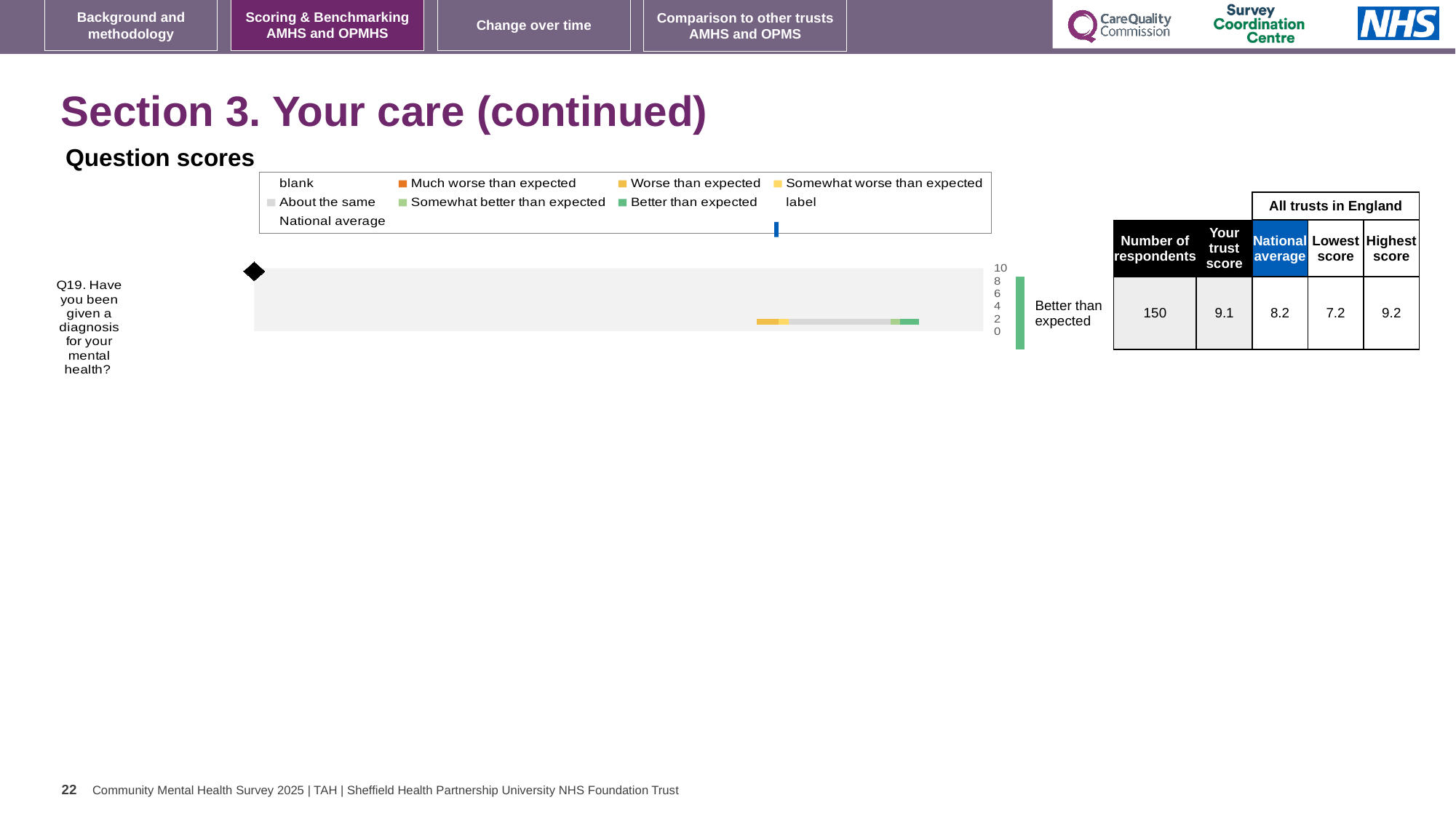
What kind of chart is shown under 'Question scores'? bar chart How many survey questions are plotted in the Question scores chart? 1 What is the highest score among all trusts in England for Q19? 9.2 What is the lowest score among all trusts in England for Q19? 7.2 What is the number of respondents for Q19? 150 What colour represents 'Much worse than expected' in the chart legend? Orange Which is larger for Q19, your trust score or the national average? Your trust score What is 'Your trust score' for Q19? 9.1 What is the national average score for Q19? 8.2 What rating label is shown next to the bar for Q19? Better than expected Which question is plotted in the Question scores chart? Q19. Have you been given a diagnosis for your mental health? What is the difference between your trust score and the national average for Q19? 0.9